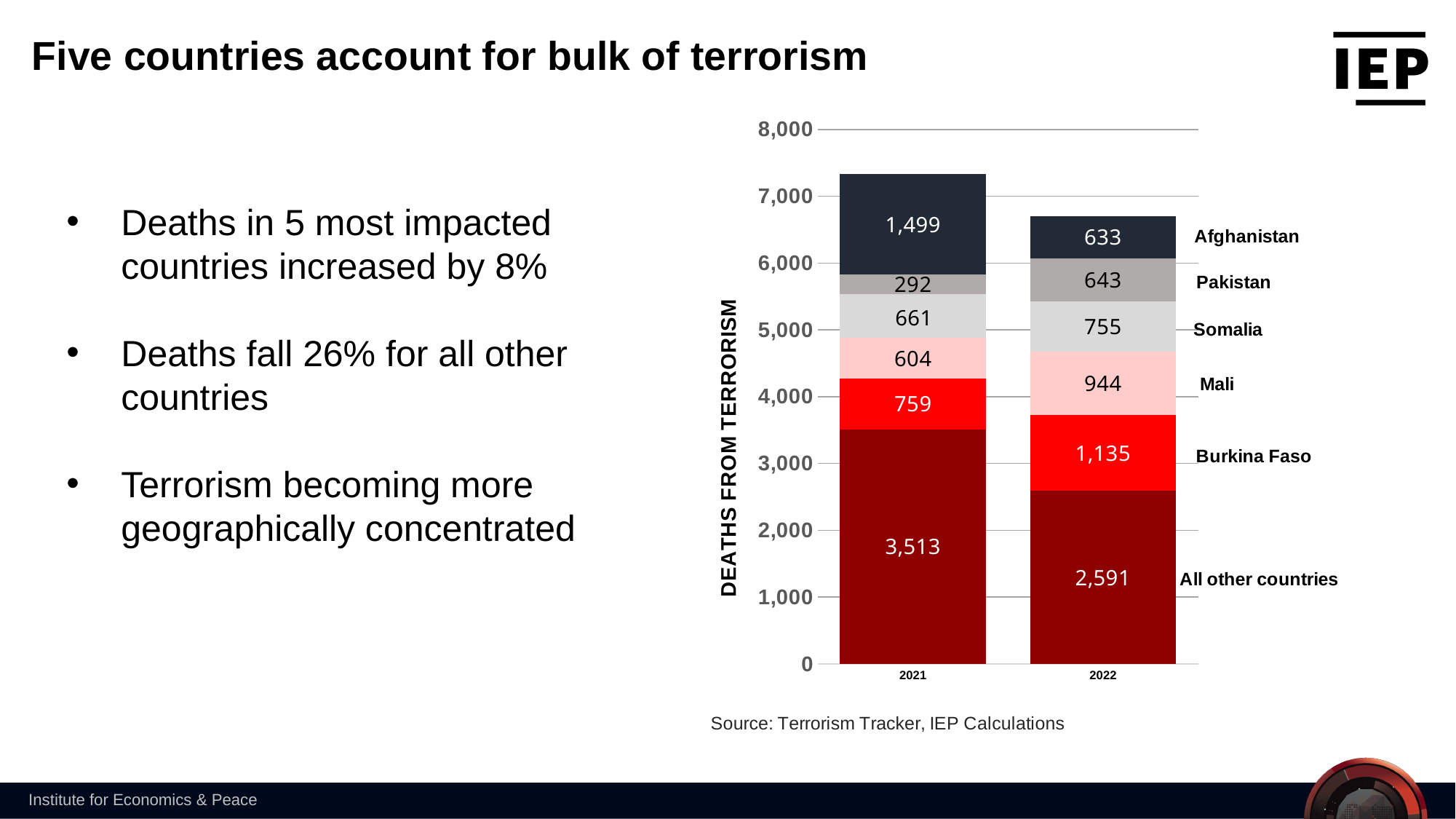
Which year has the larger value for Pakistan, 2021 or 2022? 2022 Which segment is the largest in the 2022 bar? All other countries Which segment is the smallest in the 2021 bar? Pakistan By how much did the value for All other countries fall from 2021 to 2022? 922 How many deaths from terrorism does the chart show for Afghanistan in 2021? 1,499 What is the total height of the 2022 stacked bar? 6,701 What kind of chart is shown on the slide? Stacked bar chart What is the total height of the 2021 stacked bar? 7,328 What is the value for Mali in 2021? 604 How many series (segments) are labelled in the stacked bars? 6 What is the title of the vertical axis? DEATHS FROM TERRORISM What is the value for Burkina Faso in the 2022 bar? 1,135